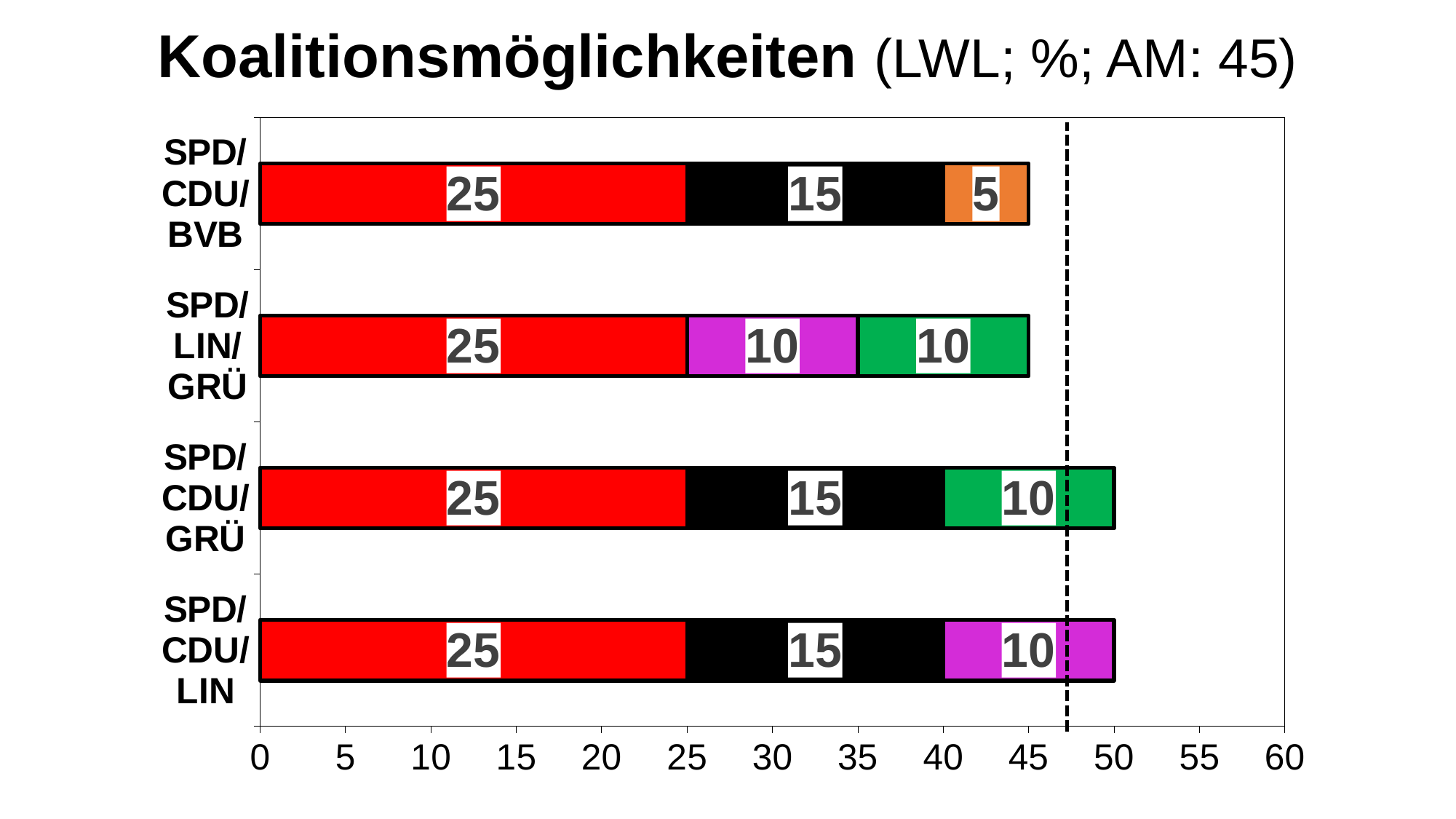
Which total is larger, SPD/CDU/LIN or SPD/LIN/GRÜ? SPD/CDU/LIN What is the value of the BVB segment in the SPD/CDU/BVB bar? 5 What is the total of the SPD/CDU/GRÜ stacked bar? 50 How many coalition options (categories) are shown in the chart? 4 What is the total of the SPD/LIN/GRÜ stacked bar? 45 What is the total of the SPD/CDU/BVB stacked bar? 45 What is the value of the SPD segment in the SPD/CDU/BVB bar? 25 What is the value of the LIN segment in the SPD/LIN/GRÜ bar? 10 What is the value of the CDU segment in the SPD/CDU/GRÜ bar? 15 What is the title of the chart? Koalitionsmöglichkeiten (LWL; %; AM: 45) What type of chart is shown on the slide? stacked bar chart What is the difference between the CDU segment and the BVB segment in the SPD/CDU/BVB bar? 10